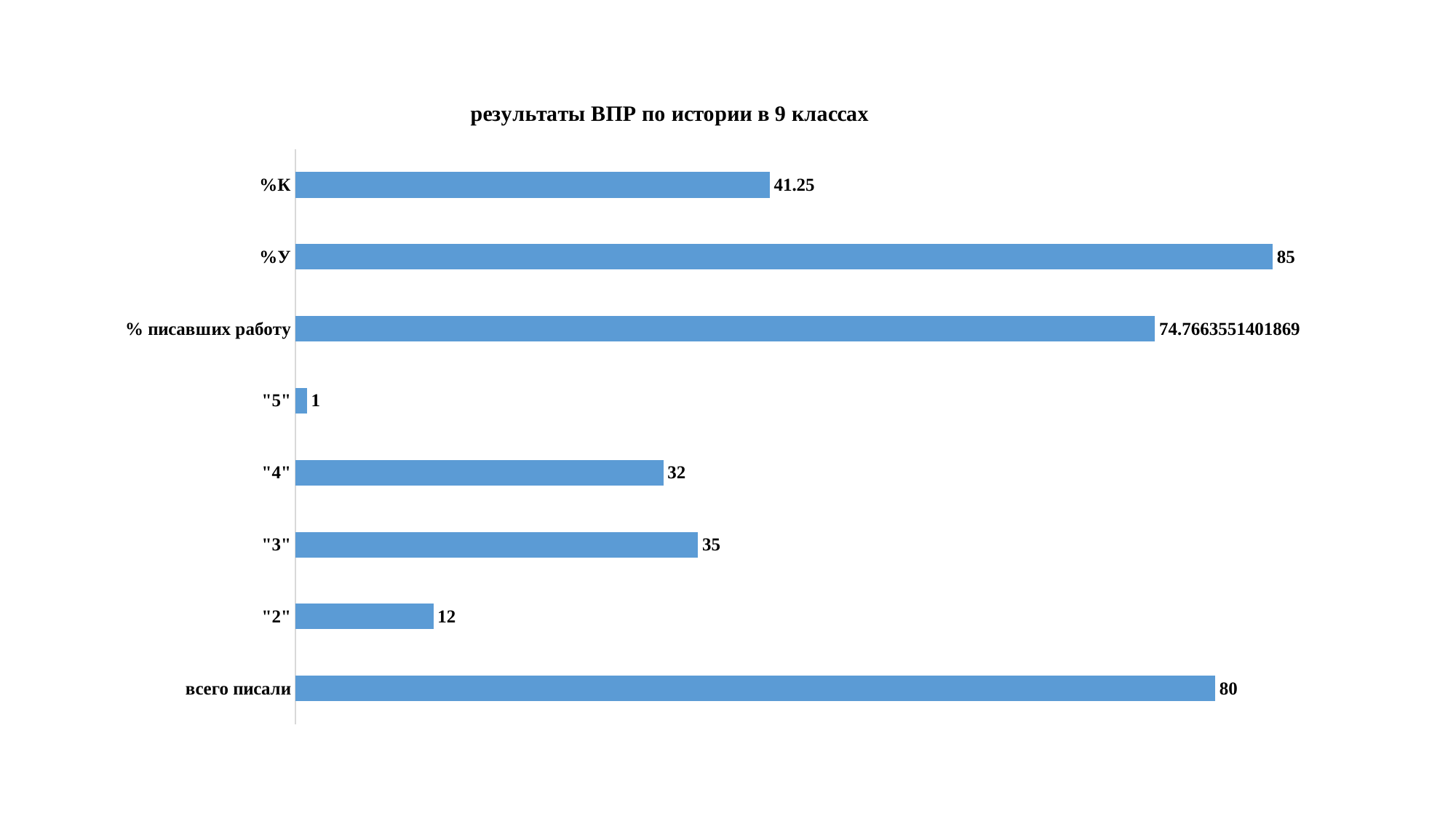
What is the difference between the values for "3" and "2"? 23 What is the value for "%К"? 41.25 What is the difference between the values for "%У" and "%К"? 43.75 What is the value for "% писавших работу"? 74.7663551401869 Which is larger, the value for "3" or the value for "4"? "3" How many categories are shown in the chart? 8 Which category has the lowest value? "5" What is the value for "всего писали"? 80 What is the value for "4"? 32 What kind of chart is this? bar chart What is the title of the chart? результаты ВПР по истории в 9 классах Which category has the highest value? %У